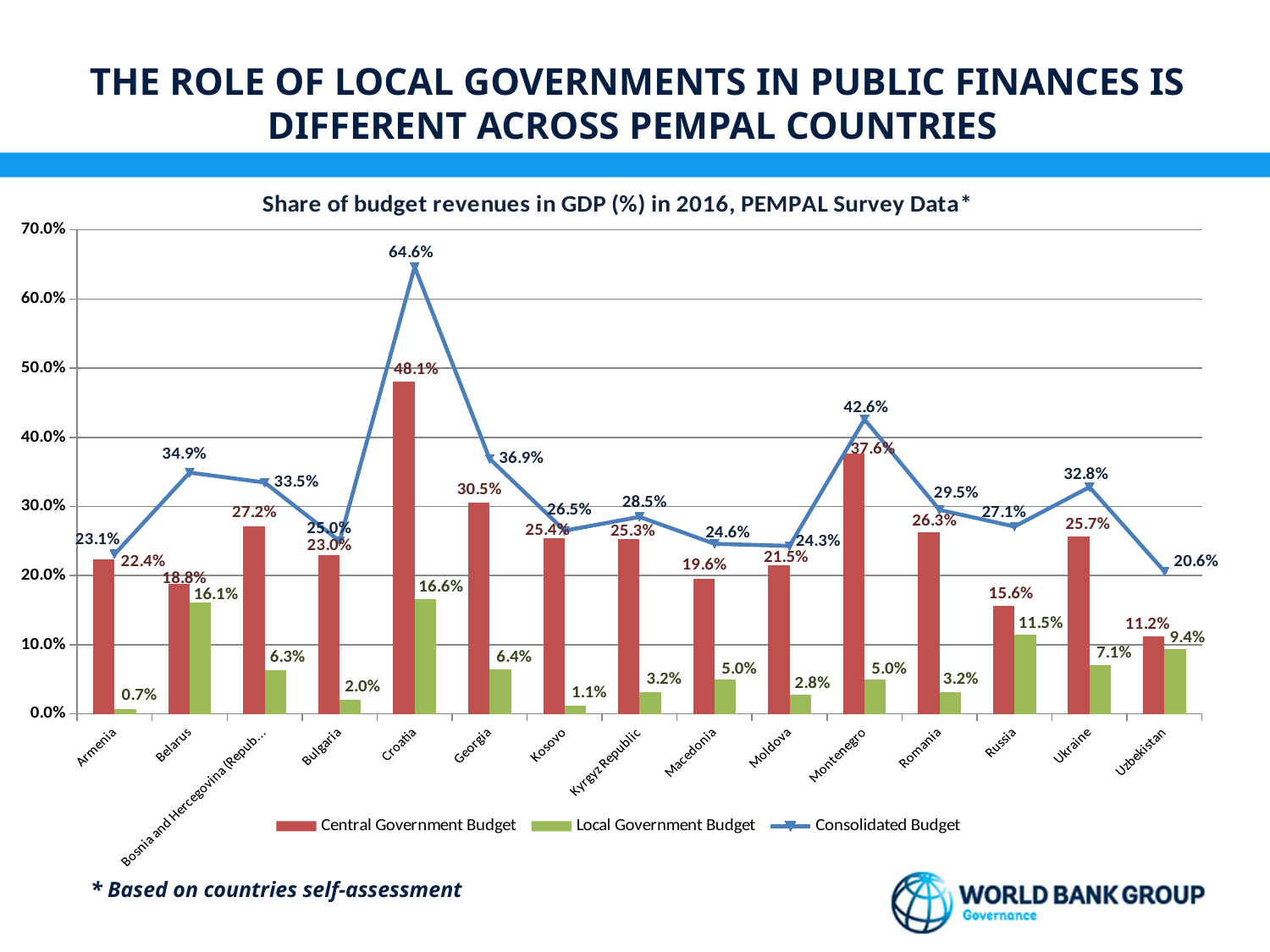
What kind of chart is this? A bar chart combined with a line chart What is the Central Government Budget value for Croatia? 48.1% Which country has the lowest Local Government Budget share? Armenia How many countries are shown on the x axis? 15 Which country has the highest Consolidated Budget share? Croatia What is the Local Government Budget value for Belarus? 16.1% What is the title of the chart? Share of budget revenues in GDP (%) in 2016, PEMPAL Survey Data* Which country has the lowest Central Government Budget share? Uzbekistan How many series does the legend list? 3 What is the Consolidated Budget value for Uzbekistan? 20.6% What is the difference between the Consolidated Budget values for Croatia and Montenegro? 22.0 percentage points Which has the larger Local Government Budget share, Russia or Uzbekistan? Russia